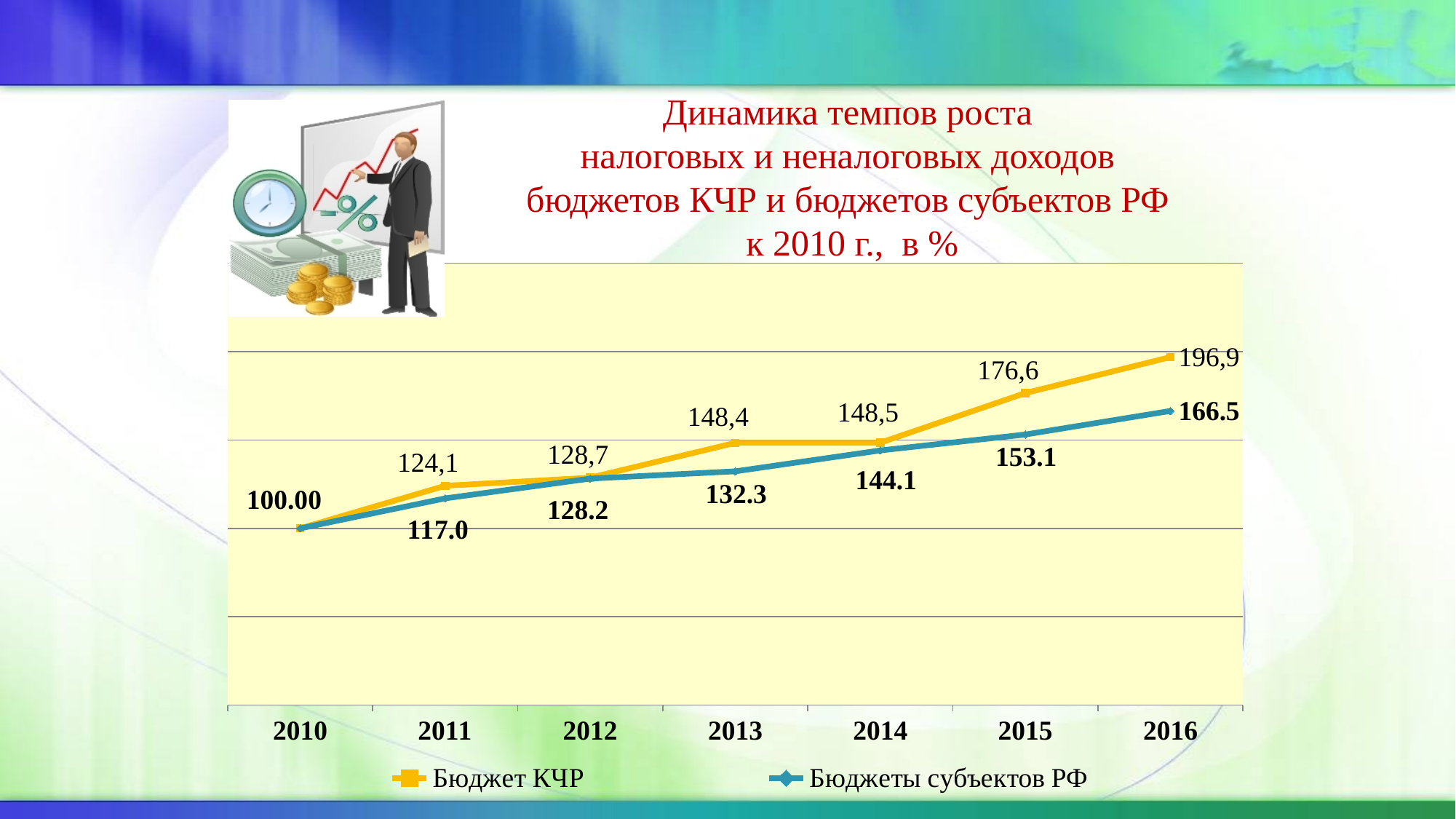
What is the value for Бюджет КЧР in 2016? 196,9 What type of chart is shown on the slide? line chart What is the value for Бюджеты субъектов РФ in 2014? 144.1 How many years are shown on the x axis? 7 How many series does the legend list? 2 Which colour is used for the Бюджет КЧР line? yellow In which year does Бюджет КЧР reach its highest value? 2016 Which series has the larger value in 2015, Бюджет КЧР or Бюджеты субъектов РФ? Бюджет КЧР What is the value for Бюджет КЧР in 2013? 148,4 What is the difference between Бюджет КЧР and Бюджеты субъектов РФ in 2016? 30.4 Do the values for Бюджеты субъектов РФ rise or fall from 2010 to 2016? rise What is the value for Бюджеты субъектов РФ in 2011? 117.0